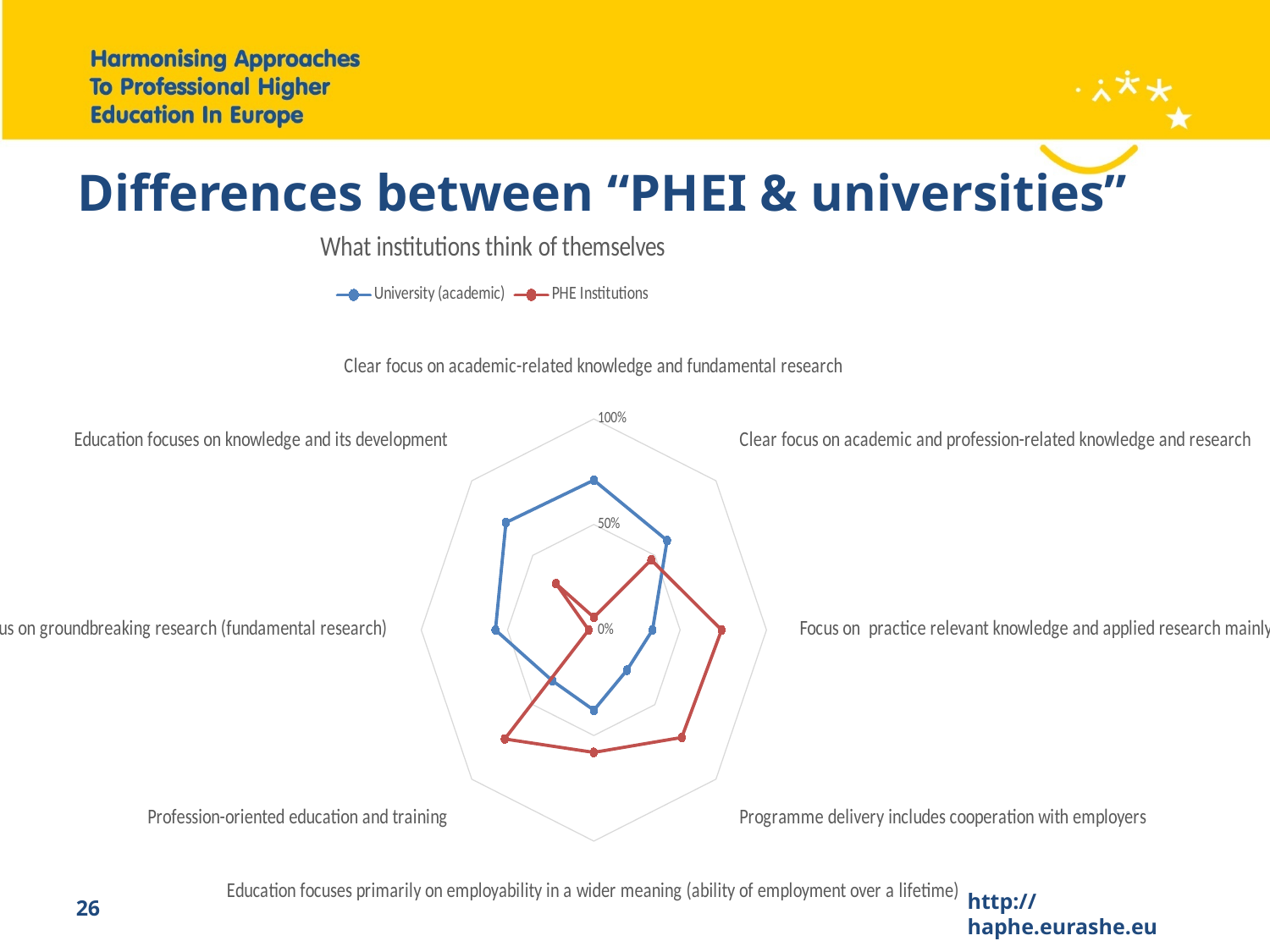
Which series is drawn in red? PHE Institutions Is the University (academic) value for 'Programme delivery includes cooperation with employers' greater or less than 50%? less For 'Education focuses primarily on employability in a wider meaning (ability of employment over a lifetime)', which series has the larger value, University (academic) or PHE Institutions? PHE Institutions How many categories (axes) does the radar chart have? 8 Is the PHE Institutions value for 'Clear focus on academic-related knowledge and fundamental research' greater or less than 50%? less How many series does the chart legend list? 2 For 'Focus on practice relevant knowledge and applied research mainly', which series has the larger value, University (academic) or PHE Institutions? PHE Institutions Is the PHE Institutions value for 'Profession-oriented education and training' greater or less than 50%? greater For 'Education focuses on knowledge and its development', which series has the larger value, University (academic) or PHE Institutions? University (academic) What is the title of the chart? What institutions think of themselves What kind of chart is shown on the slide? Radar chart